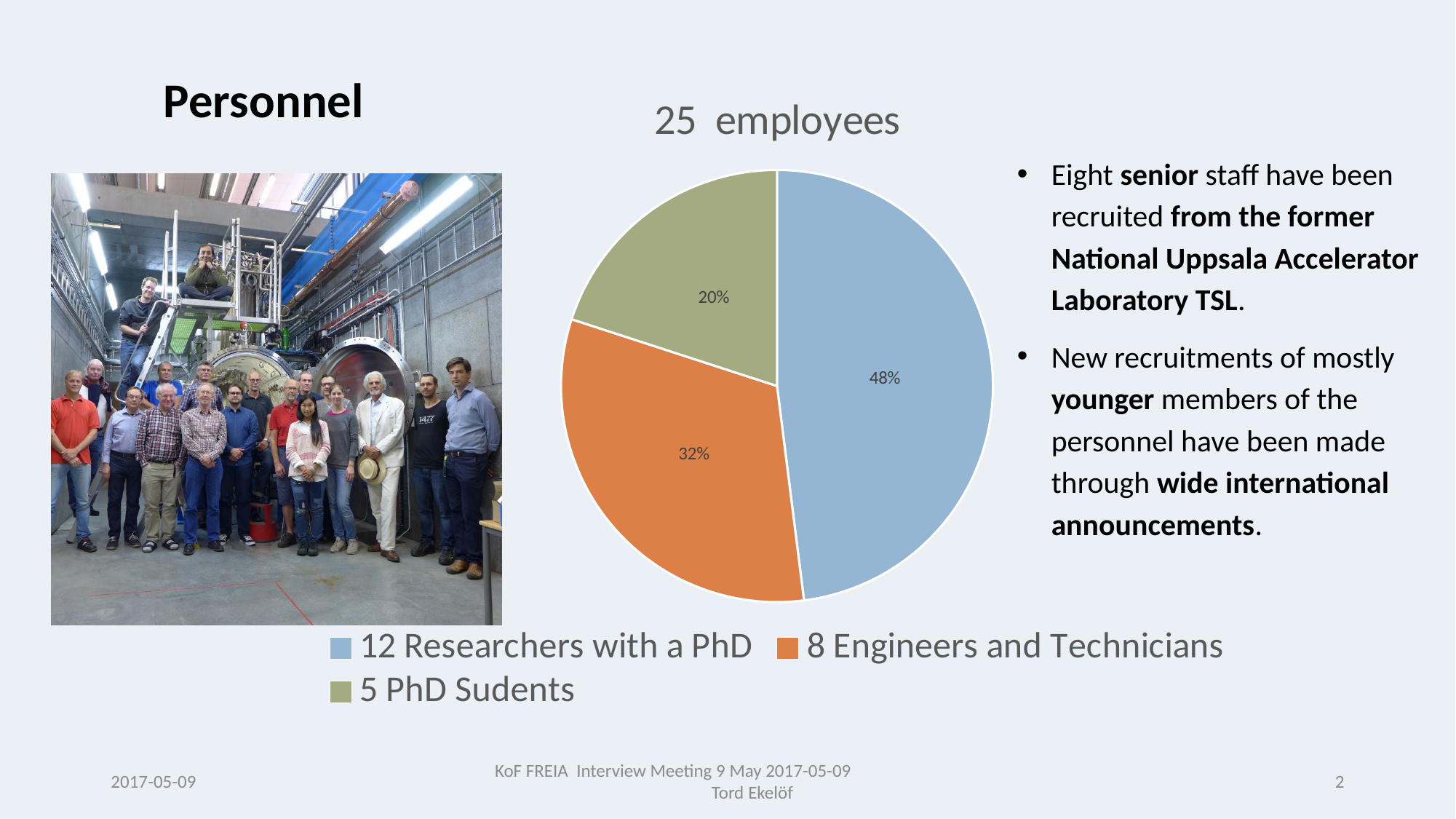
Which colour represents the 8 Engineers and Technicians slice in the pie chart? orange Which category has the smallest slice of the pie? 5 PhD Sudents What kind of chart is shown on the slide? pie chart What is the difference in percentage points between the Researchers with a PhD slice and the Engineers and Technicians slice? 16% What percentage of the pie is labelled for the slice representing 5 PhD Sudents? 20% What is the title of the pie chart? 25 employees How many slices does the pie chart have? 3 Which category has the largest slice of the pie? 12 Researchers with a PhD How many entries does the legend of the pie chart list? 3 Which slice is larger: Engineers and Technicians or PhD Sudents? 8 Engineers and Technicians What percentage of the pie is labelled for the slice representing 12 Researchers with a PhD? 48% What percentage of the pie is labelled for the slice representing 8 Engineers and Technicians? 32%